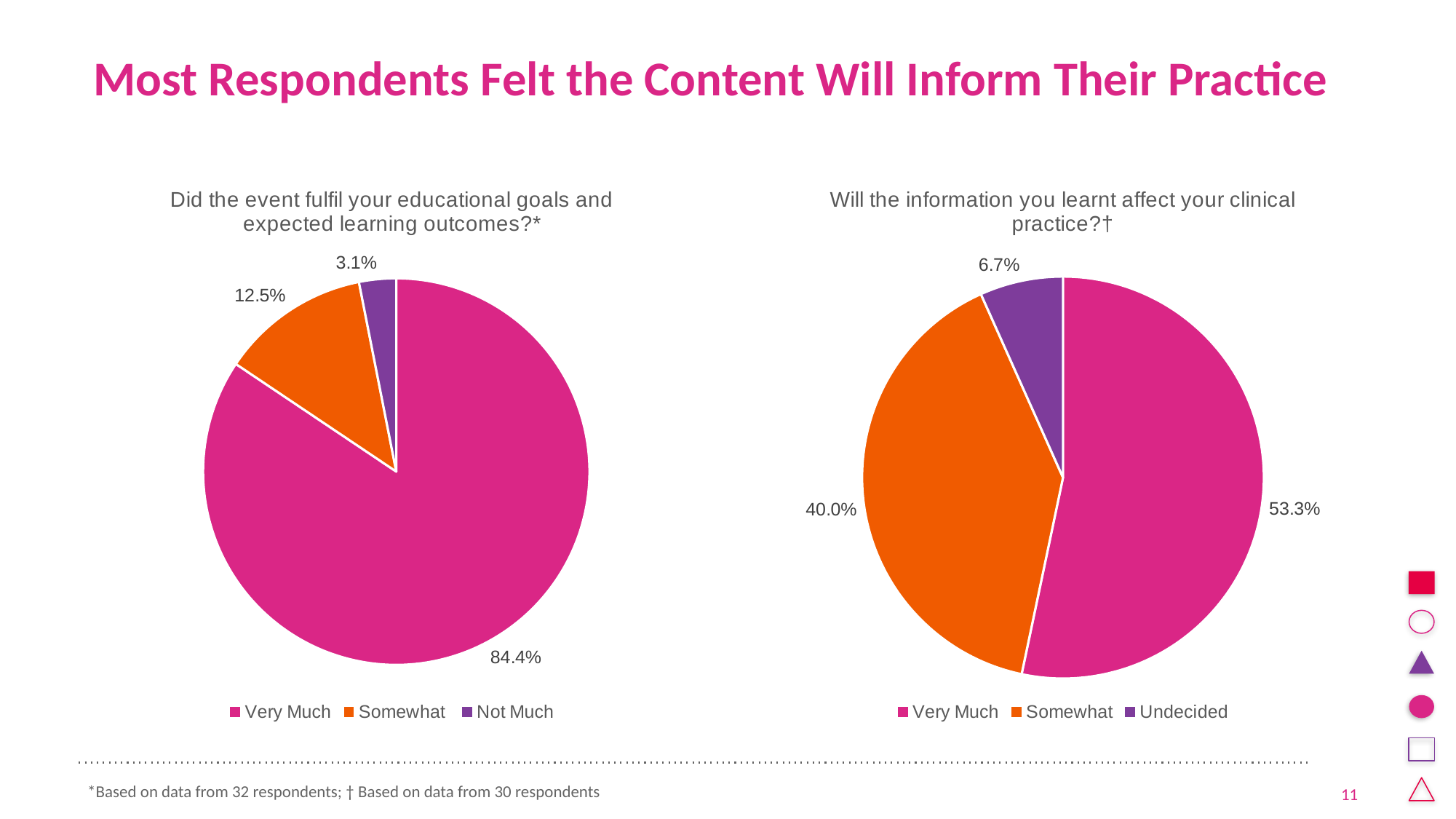
In the left pie chart (educational goals), what share of respondents answered 'Somewhat'? 12.5% In the right pie chart (clinical practice), what share of respondents answered 'Undecided'? 6.7% In the left pie chart (educational goals), what share of respondents answered 'Not Much'? 3.1% What type of chart is used on the left of the slide? Pie chart In the right pie chart (clinical practice), what share of respondents answered 'Very Much'? 53.3% In the right pie chart (clinical practice), which response has the smallest share? Undecided In the left pie chart (educational goals), which is larger: the 'Somewhat' share or the 'Not Much' share? Somewhat How many entries does the legend of the left pie chart (educational goals) list? 3 In the left pie chart (educational goals), which response has the largest share? Very Much In the left pie chart (educational goals), what share of respondents answered 'Very Much'? 84.4% How many slices does the right pie chart (clinical practice) have? 3 In the right pie chart (clinical practice), what is the difference between the 'Very Much' and 'Somewhat' shares? 13.3%